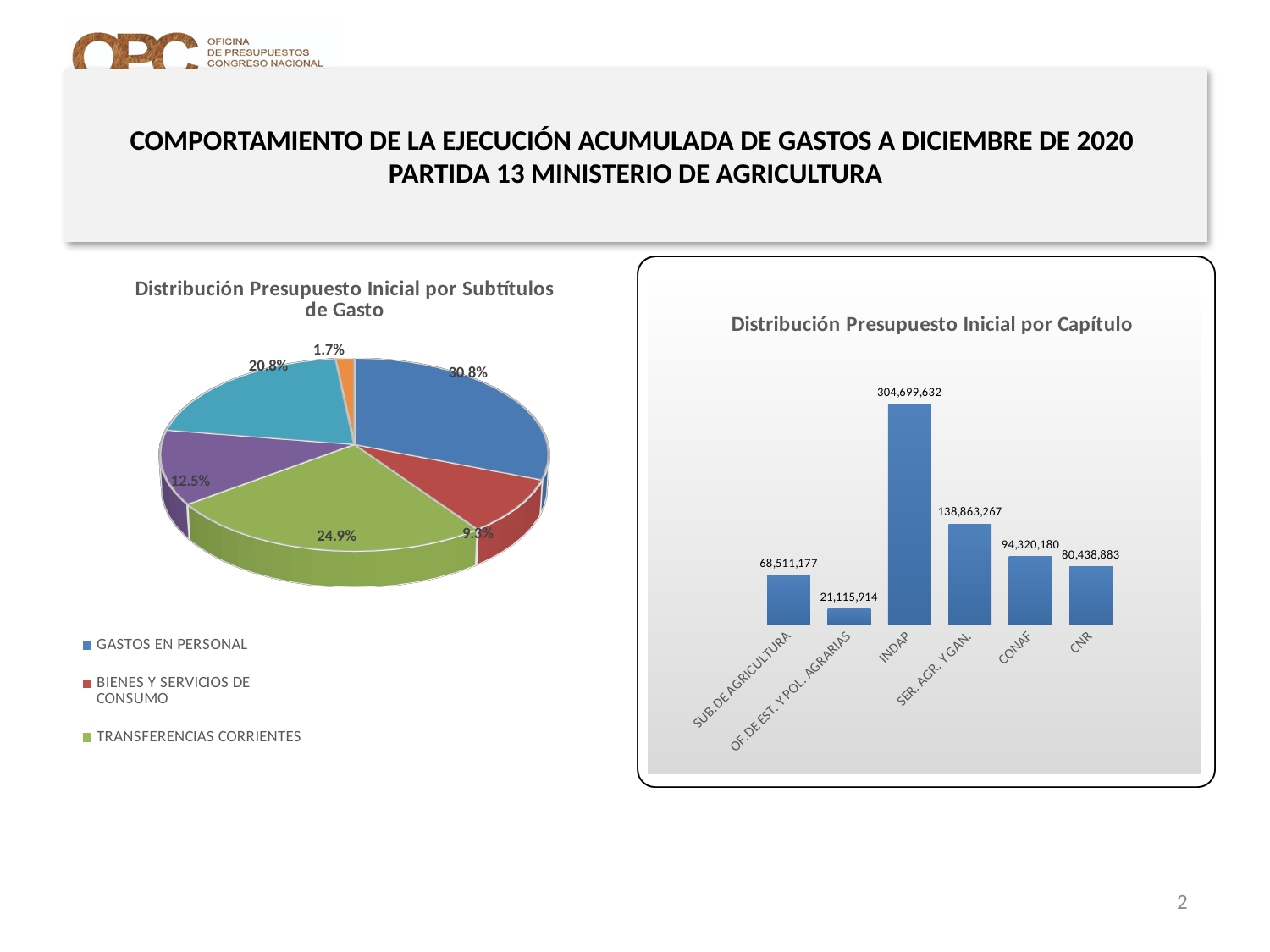
In the 'Distribución Presupuesto Inicial por Capítulo' bar chart, which is larger, CONAF or CNR? CONAF In the 'Distribución Presupuesto Inicial por Capítulo' bar chart, which category has the highest value? INDAP In the 'Distribución Presupuesto Inicial por Capítulo' bar chart, which category has the lowest value? OF. DE EST. Y POL. AGRARIAS In the 'Distribución Presupuesto Inicial por Capítulo' bar chart, what is the value for CONAF? 94,320,180 How many entries does the legend of the 'Distribución Presupuesto Inicial por Subtítulos de Gasto' pie chart list? 3 How many categories are shown in the 'Distribución Presupuesto Inicial por Capítulo' bar chart? 6 In the 'Distribución Presupuesto Inicial por Capítulo' bar chart, what is the difference between the values for INDAP and SER. AGR. Y GAN.? 165,836,365 What kind of chart is 'Distribución Presupuesto Inicial por Capítulo'? Bar chart In the 'Distribución Presupuesto Inicial por Subtítulos de Gasto' pie chart, what share does GASTOS EN PERSONAL have? 30.8% In the 'Distribución Presupuesto Inicial por Capítulo' bar chart, what is the value for INDAP? 304,699,632 In the 'Distribución Presupuesto Inicial por Subtítulos de Gasto' pie chart, what share does TRANSFERENCIAS CORRIENTES have? 24.9% What kind of chart is 'Distribución Presupuesto Inicial por Subtítulos de Gasto'? Pie chart